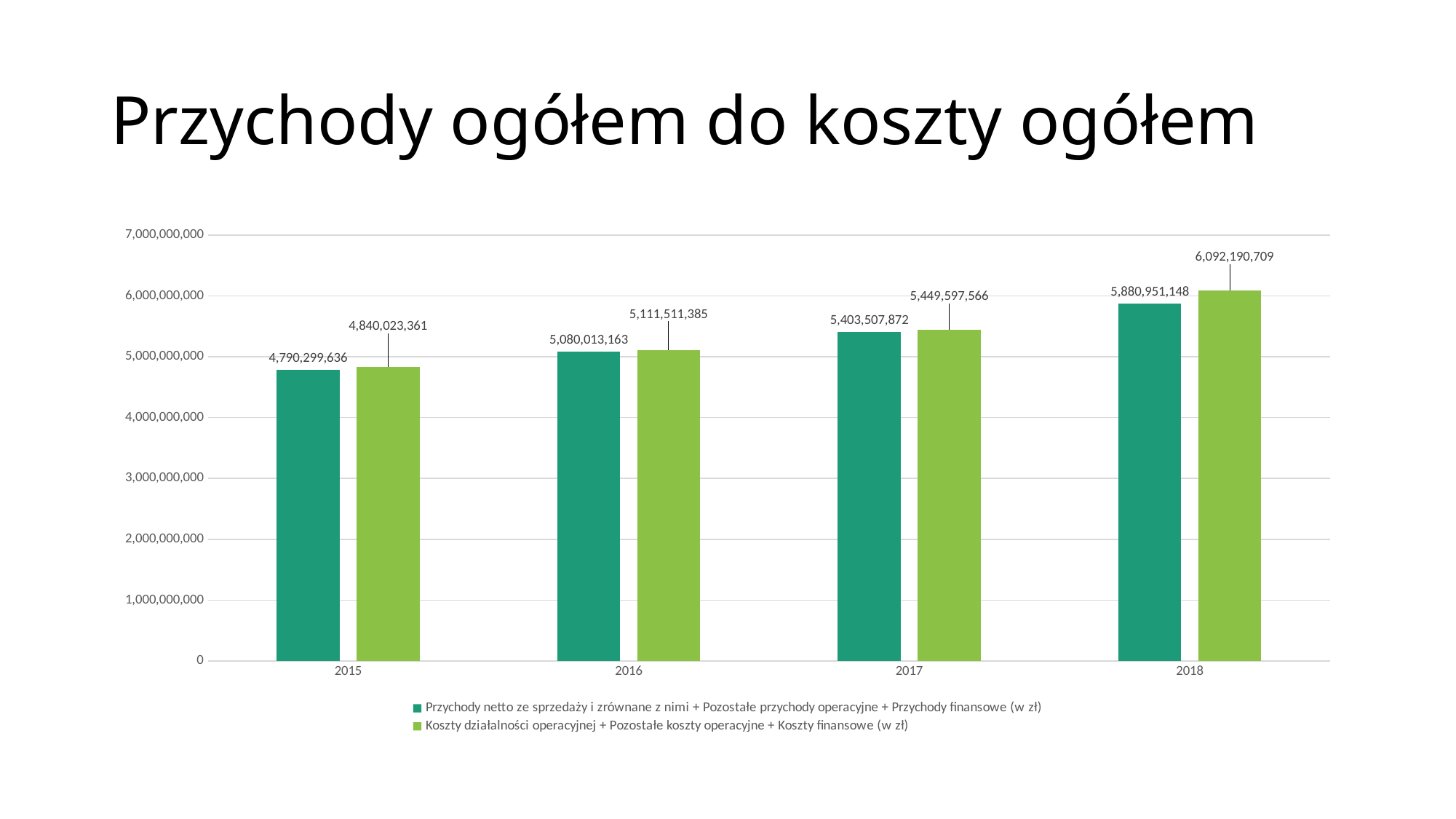
What is the value of the light green costs bar for 2016? 5,111,511,385 What is the value of the light green bar (Koszty działalności operacyjnej + Pozostałe koszty operacyjne + Koszty finansowe) for 2018? 6,092,190,709 Is the value of the dark green revenues bar for 2016 greater or less than 5,000,000,000? greater In which year is the light green costs bar the highest? 2018 How many series does the legend list? 2 In which year is the dark green revenues bar the lowest? 2015 By how much did the dark green revenues bar increase from 2015 to 2018? 1,090,651,512 What is the value of the dark green revenues bar for 2017? 5,403,507,872 What is the value of the dark green bar (Przychody netto ze sprzedaży i zrównane z nimi + Pozostałe przychody operacyjne + Przychody finansowe) for 2015? 4,790,299,636 What is the difference between the light green costs bar and the dark green revenues bar in 2018? 211,239,561 How many years are shown on the x axis? 4 In 2018, which is larger: the dark green revenues bar or the light green costs bar? The light green costs bar